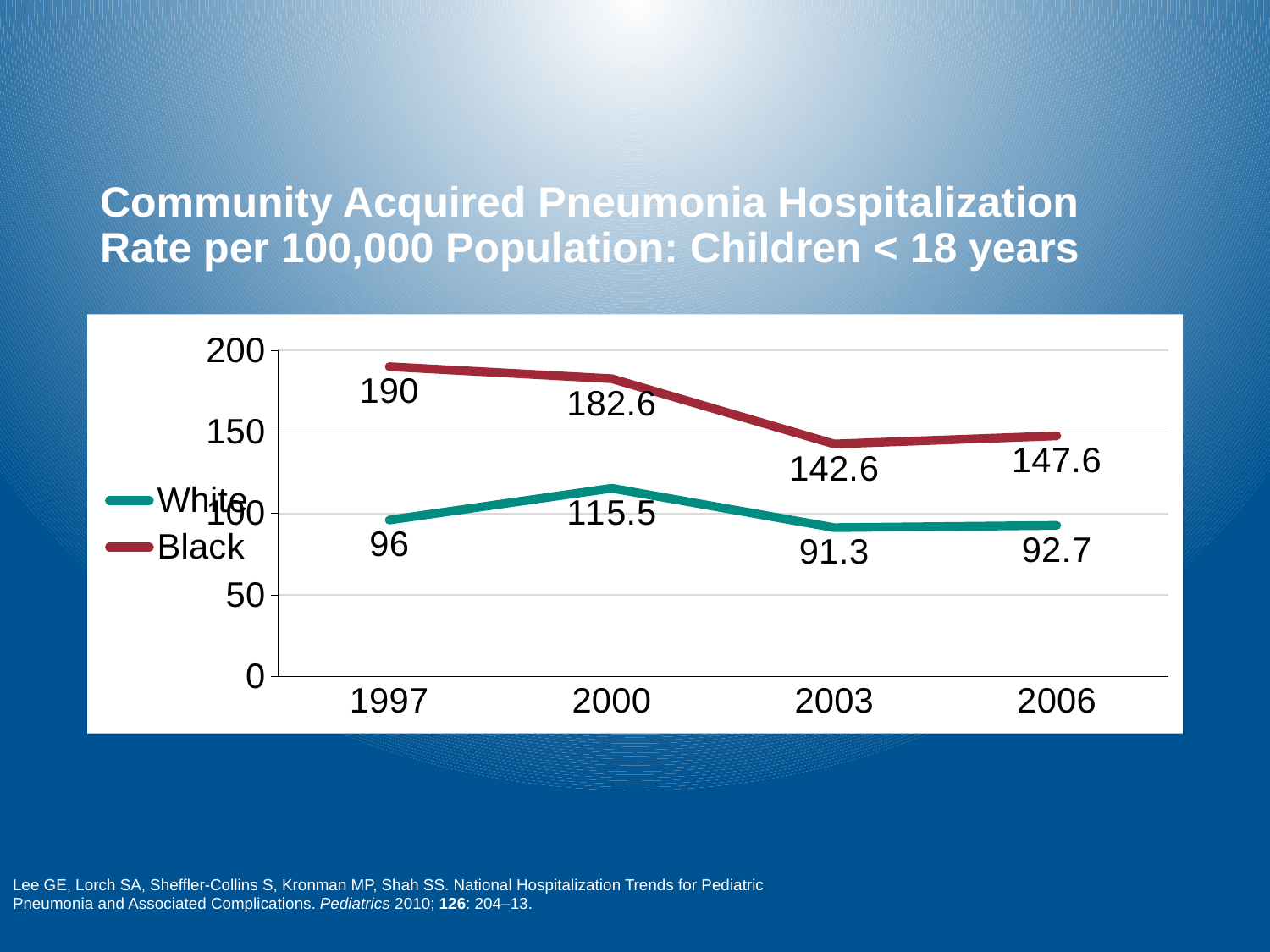
Does the rate for Black children rise or fall from 1997 to 2003? Fall What is the hospitalization rate for White children in 2006? 92.7 What kind of chart is shown? Line chart What is the hospitalization rate for Black children in 2003? 142.6 How many series does the legend list? 2 How many years are shown on the x axis? 4 Which is larger, the Black rate in 2006 or the White rate in 2000? Black rate in 2006 What is the hospitalization rate for Black children in 1997? 190 What is the hospitalization rate for White children in 2000? 115.5 What is the difference between the Black and White rates in 1997? 94 In which year is the rate for Black children lowest? 2003 In which year is the rate for White children highest? 2000